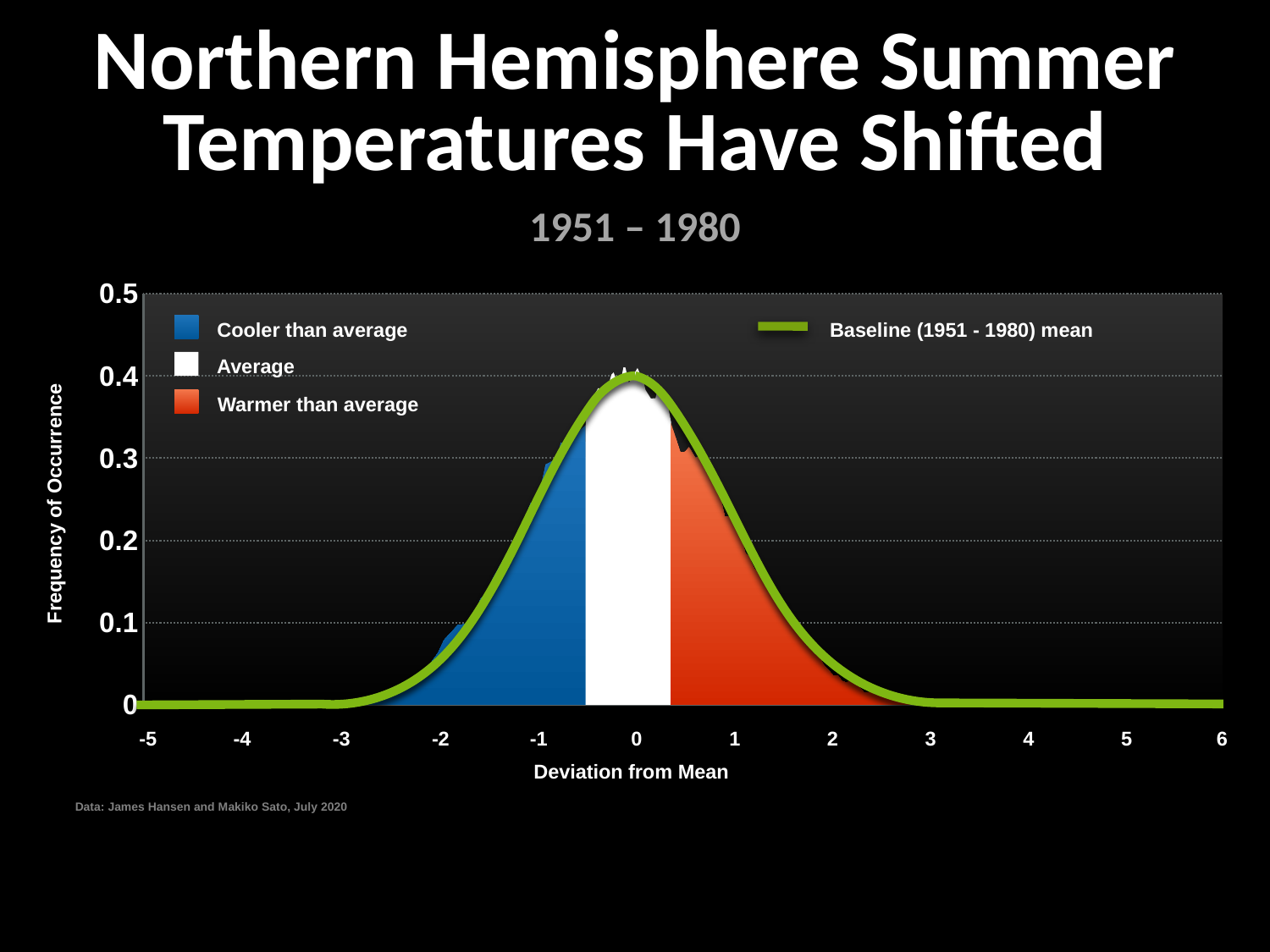
Does the curve rise or fall as the deviation from mean goes from 0 to 6? fall Is the frequency of occurrence at a deviation of 2 greater or less than 0.1? less Does the curve rise or fall as the deviation from mean goes from -5 to 0? rise Which has a higher frequency of occurrence: a deviation of -1 or a deviation of -3? -1 Is the frequency of occurrence at a deviation of -3 greater or less than 0.1? less Is the peak frequency of occurrence at a deviation of 0 greater or less than 0.3? greater At which deviation from mean does the curve reach its highest frequency of occurrence? 0 Which has a higher frequency of occurrence: a deviation of 0 or a deviation of 2? 0 What colour represents 'Warmer than average' in the legend? Red/orange What kind of chart is shown on the slide? Area chart with a line How many entries does the legend list? 4